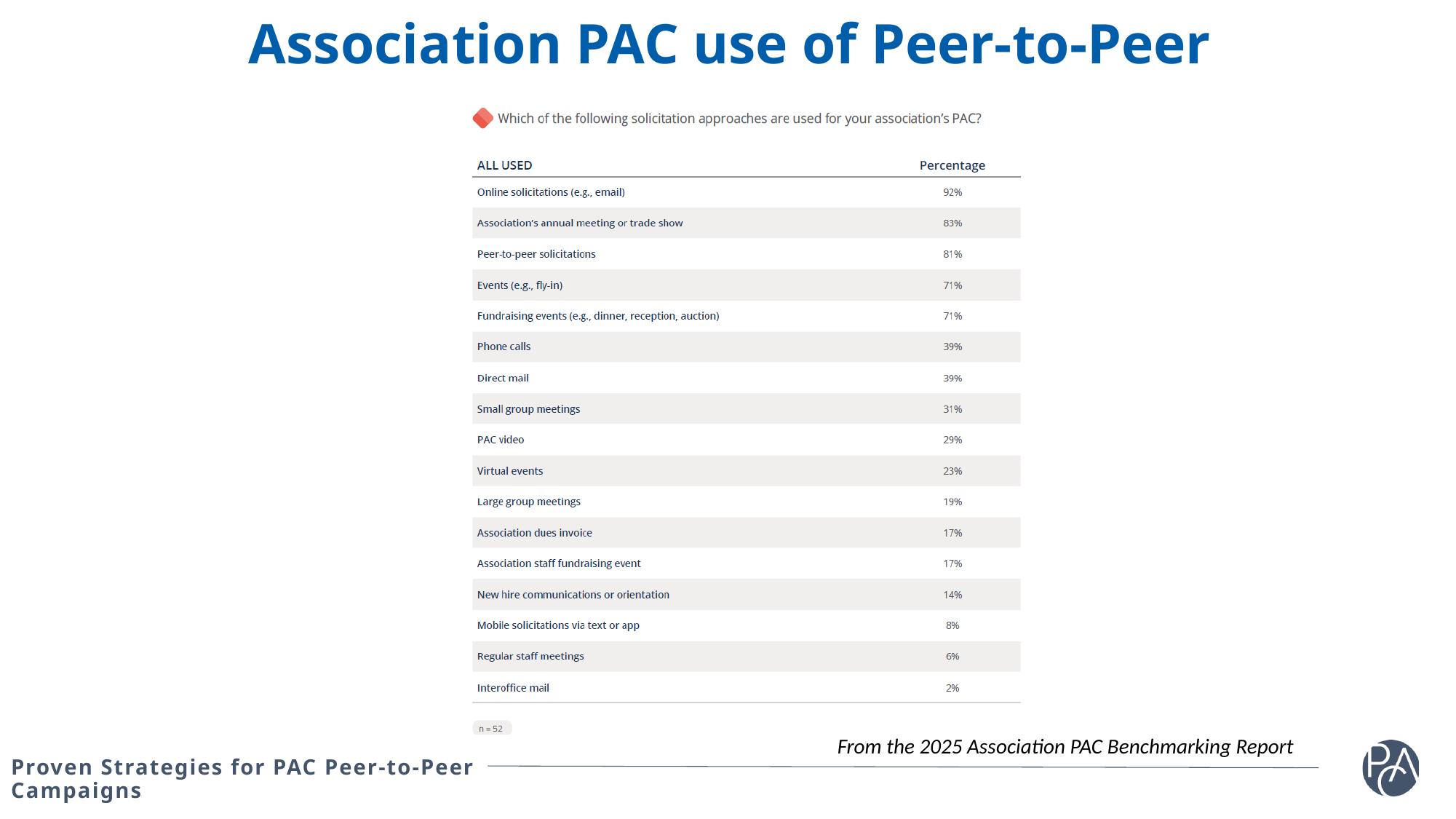
What is the difference in percentage points between online solicitations and peer-to-peer solicitations? 11 Which solicitation approach has the lowest percentage? Interoffice mail What is the title of the slide? Association PAC use of Peer-to-Peer What percentage is shown for online solicitations (e.g., email)? 92% What is the sample size (n) shown below the table? 52 What percentage of association PACs use peer-to-peer solicitations? 81% Which solicitation approach has the highest percentage? Online solicitations (e.g., email) Which has a higher percentage, small group meetings or large group meetings? Small group meetings Which has a higher percentage, PAC video or mobile solicitations via text or app? PAC video How many solicitation approaches are listed in the table? 17 What is the difference in percentage points between the association's annual meeting or trade show and virtual events? 60 What percentage is listed for phone calls? 39%